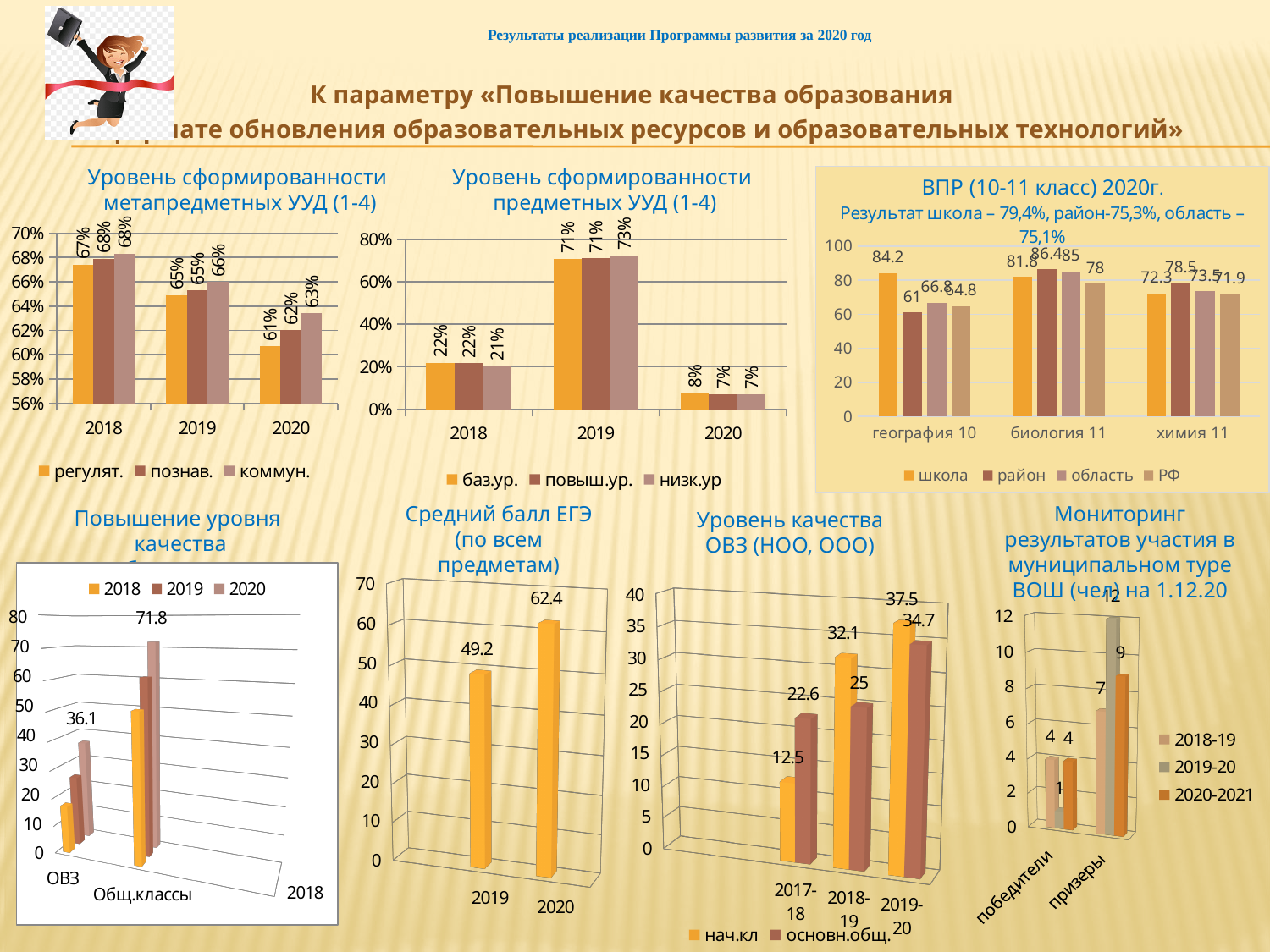
In the chart 'Уровень качества ОВЗ (НОО, ООО)', how does the 'нач.кл' series change from 2017-18 to 2019-20? It rises What kind of chart is 'Мониторинг результатов участия в муниципальном туре ВОШ'? Bar chart In the chart 'Мониторинг результатов участия в муниципальном туре ВОШ', what is the value of '2019-20' for 'призеры'? 12 In the chart 'Средний балл ЕГЭ (по всем предметам)', what is the difference between the 2020 and 2019 values? 13.2 In the chart 'Уровень сформированности предметных УУД (1-4)', which year has the highest value for 'баз.ур.'? 2019 In the chart 'ВПР (10-11 класс) 2020г.', what is the value of 'школа' for 'география 10'? 84.2 In the chart 'Уровень качества ОВЗ (НОО, ООО)', what is the value of 'нач.кл' for 2019-20? 37.5 In the chart 'Уровень сформированности метапредметных УУД (1-4)', what is the value of 'коммун.' for 2020? 63% In the chart 'Уровень сформированности метапредметных УУД (1-4)', how many series does the legend list? 3 In the chart 'Уровень сформированности предметных УУД (1-4)', what is the value of 'низк.ур' for 2018? 21% In the chart 'ВПР (10-11 класс) 2020г.', which is larger for 'география 10': 'школа' or 'район'? школа In the chart 'Средний балл ЕГЭ (по всем предметам)', what is the value for 2020? 62.4